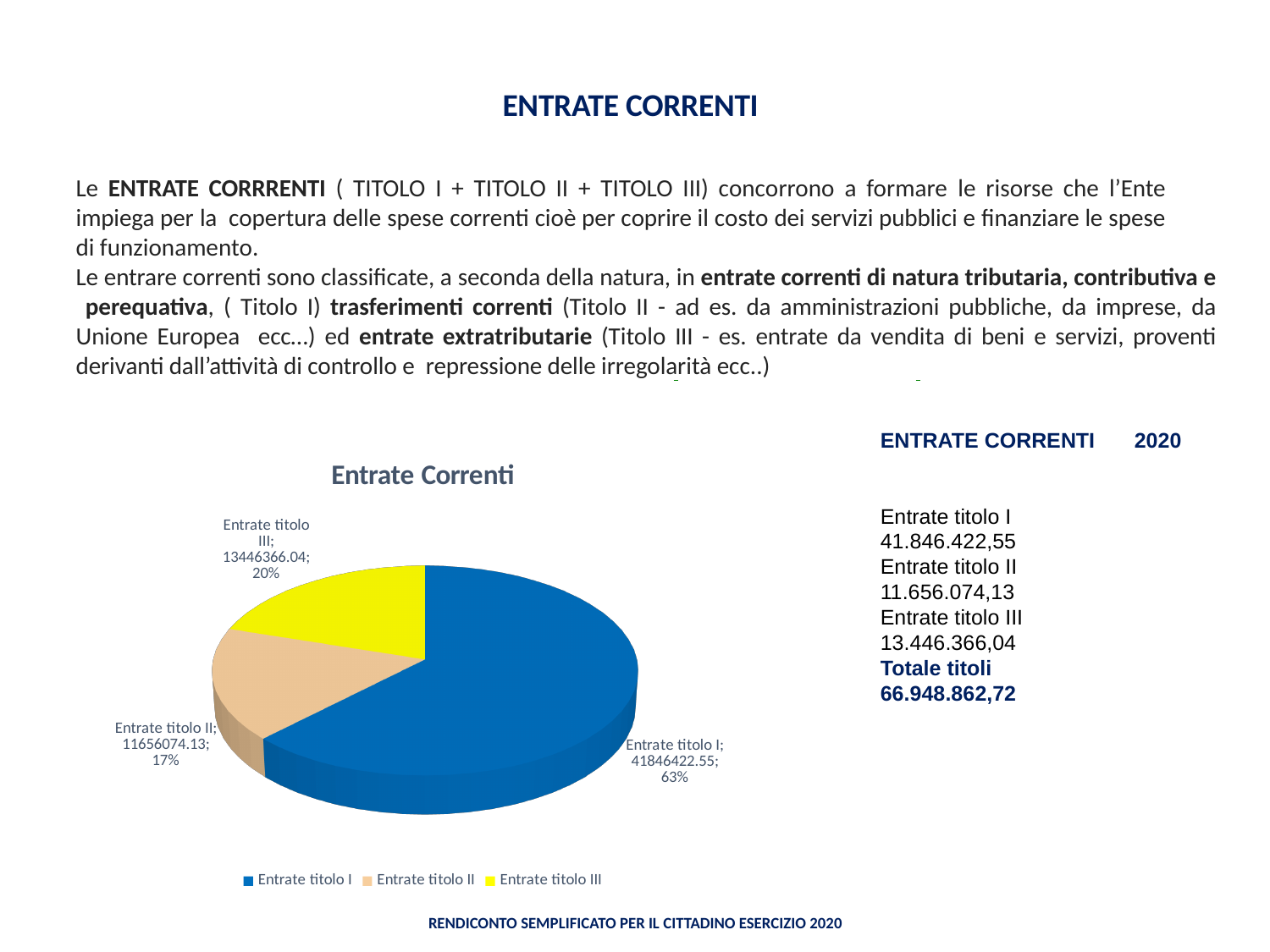
What is the value shown for Entrate titolo III in the pie chart? 13446366.04 How many slices does the pie chart have? 3 Which is larger in the pie chart, Entrate titolo II or Entrate titolo III? Entrate titolo III What is the title of the pie chart? Entrate Correnti What is the value shown for Entrate titolo I in the pie chart? 41846422.55 Which category has the smallest slice in the pie chart? Entrate titolo II Which category has the largest slice in the pie chart? Entrate titolo I What is the difference between the values for Entrate titolo I and Entrate titolo III in the pie chart? 28400056.51 What type of chart is shown on the slide? pie chart What percentage share of the pie does Entrate titolo III represent? 20% What percentage share of the pie does Entrate titolo I represent? 63% What is the value shown for Entrate titolo II in the pie chart? 11656074.13